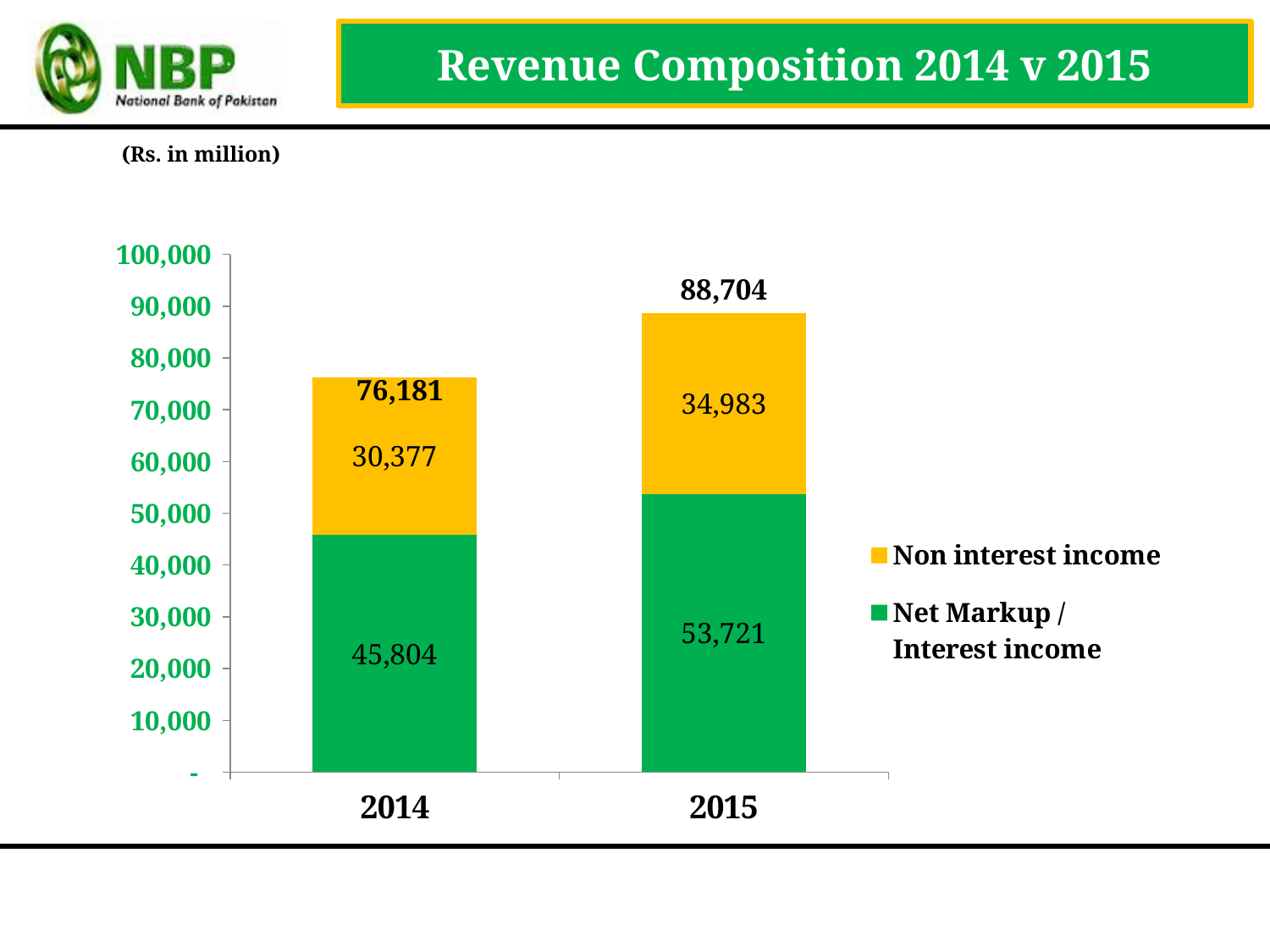
What is the Net Markup / Interest income value for 2015? 53,721 What is the Non interest income value for 2015? 34,983 Which year has the higher total revenue? 2015 How many series does the legend list? 2 What is the Non interest income value for 2014? 30,377 What kind of chart is shown on the slide? Stacked bar chart Is the Net Markup / Interest income for 2015 greater or less than 50,000? greater What is the total of the stacked bar for 2015? 88,704 What is the difference between the Net Markup / Interest income values for 2015 and 2014? 7,917 What is the difference between the Non interest income values for 2015 and 2014? 4,606 What is the Net Markup / Interest income value for 2014? 45,804 What is the total of the stacked bar for 2014? 76,181